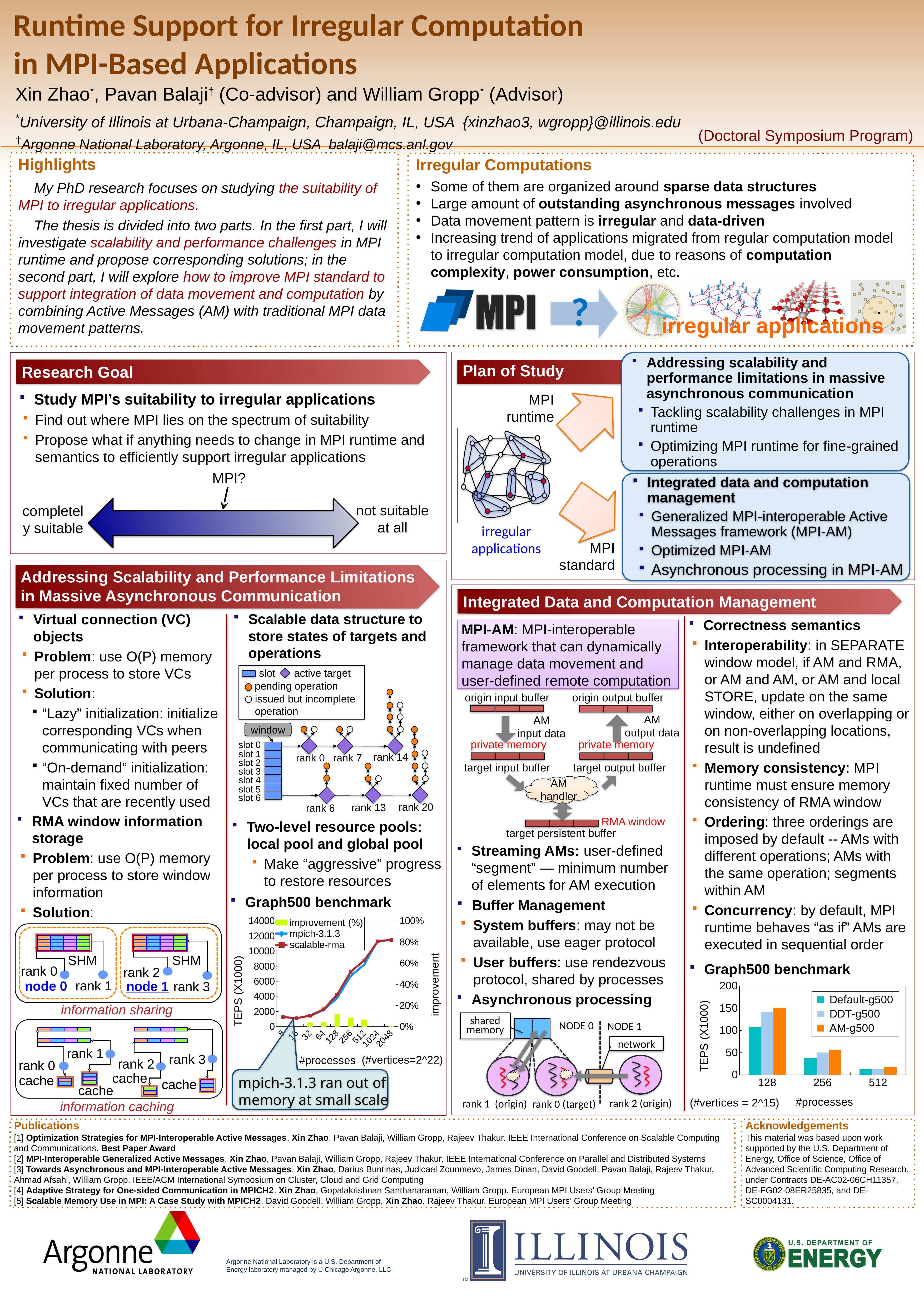
On the Graph500 benchmark chart in the lower-left section, how many series does the legend list? 3 On the Graph500 benchmark chart in the lower-right section, how many series does the legend list? 3 On the Graph500 benchmark chart in the lower-left section, how many #processes values are shown on the x axis? 9 On the Graph500 benchmark chart in the lower-left section, does the scalable-rma TEPS value rise or fall as #processes increases? rise On the Graph500 benchmark chart in the lower-right section, is the AM-g500 value at 128 processes greater or less than 100? greater On the Graph500 benchmark chart in the lower-right section, do the TEPS values rise or fall as #processes increases? fall On the Graph500 benchmark chart in the lower-right section, which is larger at 256 processes, Default-g500 or AM-g500? AM-g500 On the Graph500 benchmark chart in the lower-right section (Default-g500, DDT-g500, AM-g500), what kind of chart is it? bar chart On the Graph500 benchmark chart in the lower-left section, is the scalable-rma value at 2048 processes greater or less than 10000? greater On the Graph500 benchmark chart in the lower-left section, is the scalable-rma value at 8 processes greater or less than 4000? less On the Graph500 benchmark chart in the lower-right section, how many #processes categories are shown? 3 On the Graph500 benchmark chart in the lower-left section (with TEPS and improvement axes), what kind of chart is it? line chart with bars